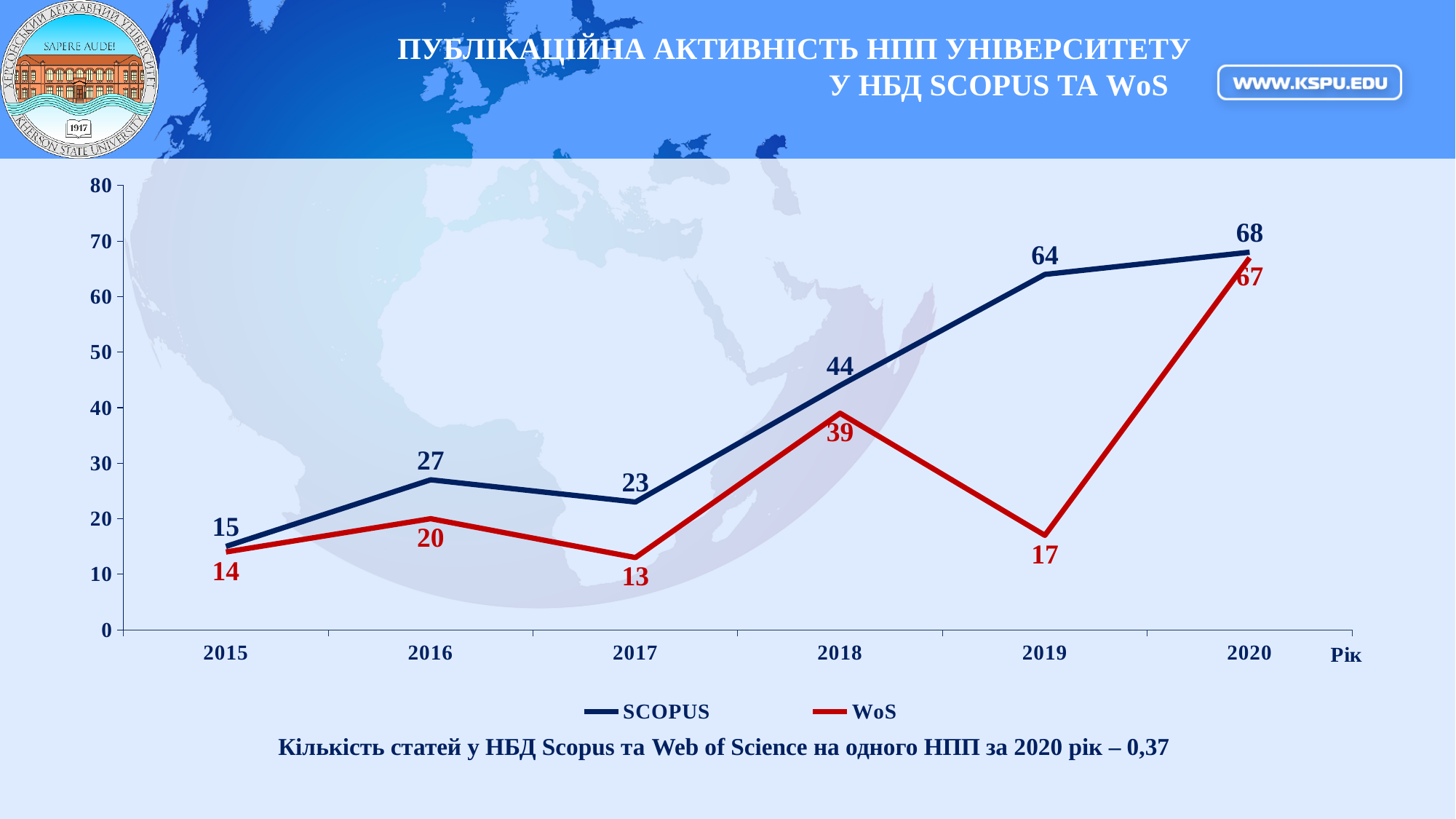
In which year is the SCOPUS value highest? 2020 What colour is the WoS line? red How many series does the legend list? 2 Which is larger in 2018, the SCOPUS value or the WoS value? SCOPUS What is the WoS value for 2019? 17 What is the WoS value for 2016? 20 What is the SCOPUS value for 2018? 44 Does the SCOPUS value rise or fall from 2017 to 2020? rise In which year is the WoS value lowest? 2017 What kind of chart is shown on the slide? line chart How many years are shown on the x axis? 6 What is the difference between the SCOPUS and WoS values in 2019? 47